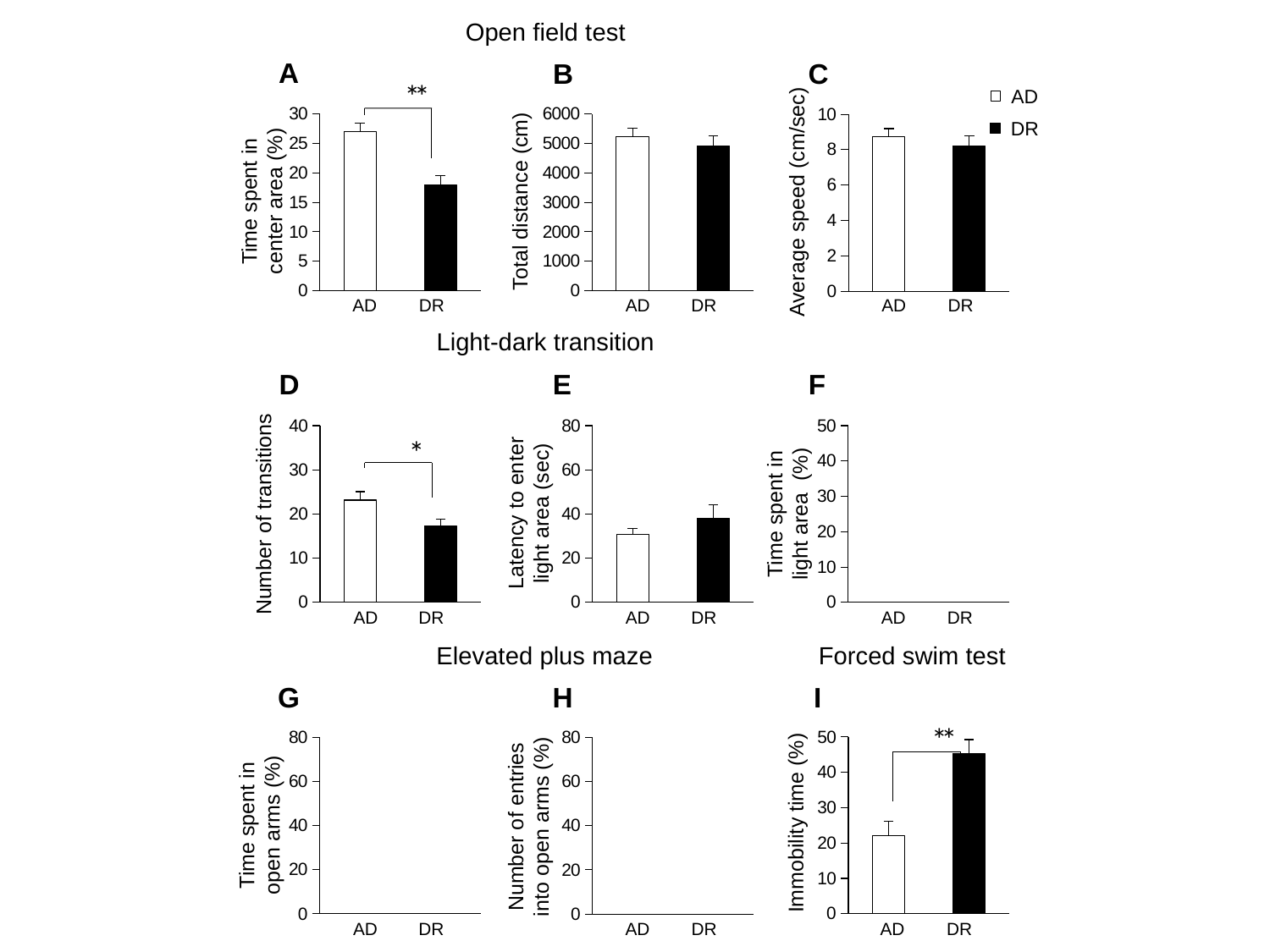
In chart I (Immobility time), is the value for AD greater or less than 30? less In chart D (Number of transitions), which group has the lower value, AD or DR? DR In chart A (Time spent in center area), is the value for DR greater or less than 20? less In chart I (Immobility time), is the value for DR greater or less than 40? greater In chart E (Latency to enter light area), which group has the higher value, AD or DR? DR How many groups does the legend in the top-right list? 2 What kind of chart is chart I (Immobility time)? bar chart In chart A (Time spent in center area), which group has the higher value, AD or DR? AD